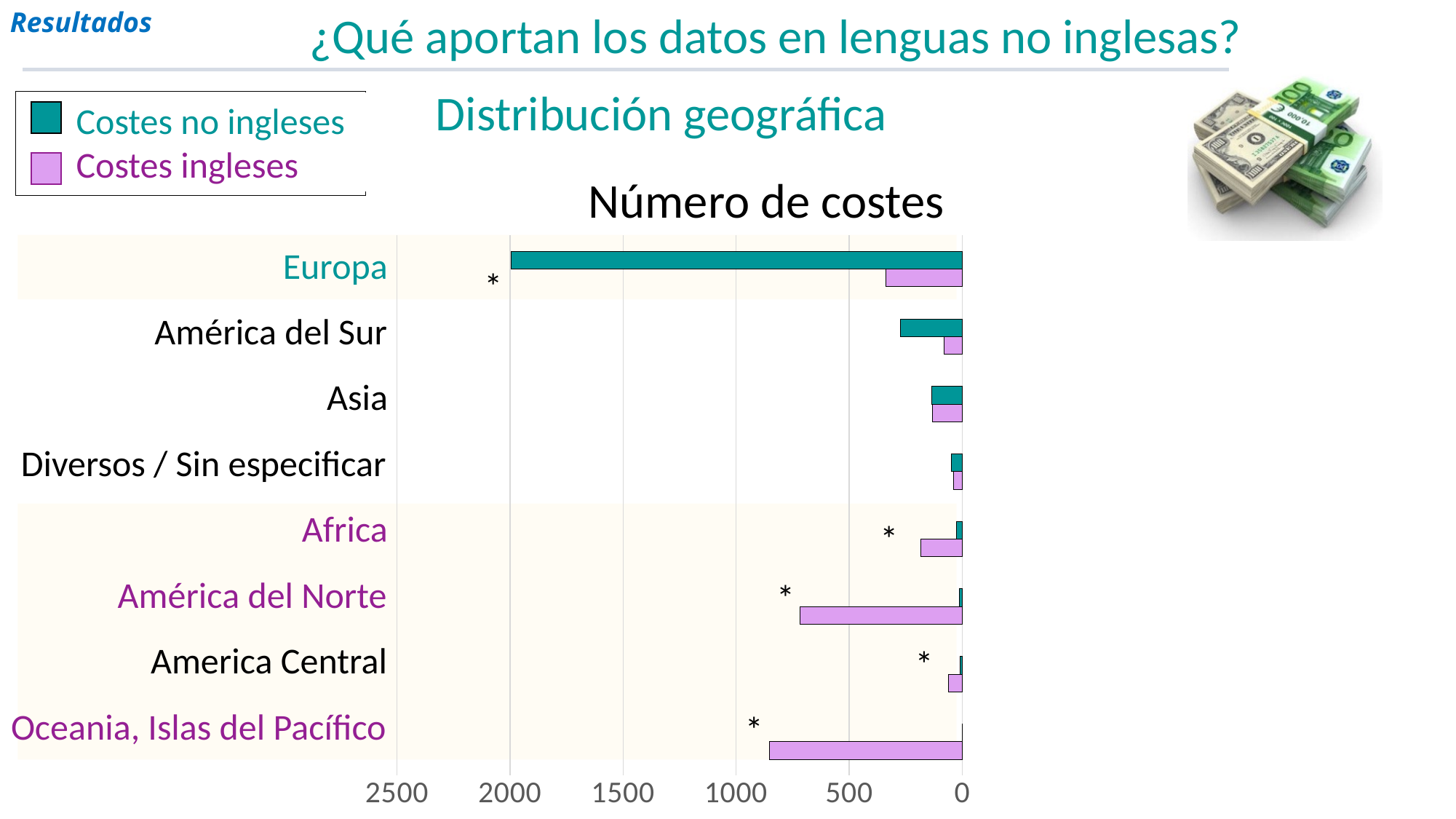
Is the 'Costes no ingleses' value for Europa greater or less than 1500? greater Is the 'Costes ingleses' value for Europa greater or less than 500? less Which category has the highest value for 'Costes ingleses'? Oceania, Islas del Pacífico Which category has the highest value for 'Costes no ingleses'? Europa Is the 'Costes ingleses' value for América del Norte greater or less than 500? greater Which colour represents the series 'Costes ingleses'? purple How many geographic categories are plotted in the chart? 8 Which category has the lowest value for 'Costes no ingleses'? Oceania, Islas del Pacífico How many series does the legend list? 2 What kind of chart is shown on the slide? bar chart For América del Norte, which is larger: 'Costes no ingleses' or 'Costes ingleses'? Costes ingleses What is the title of the chart? Número de costes